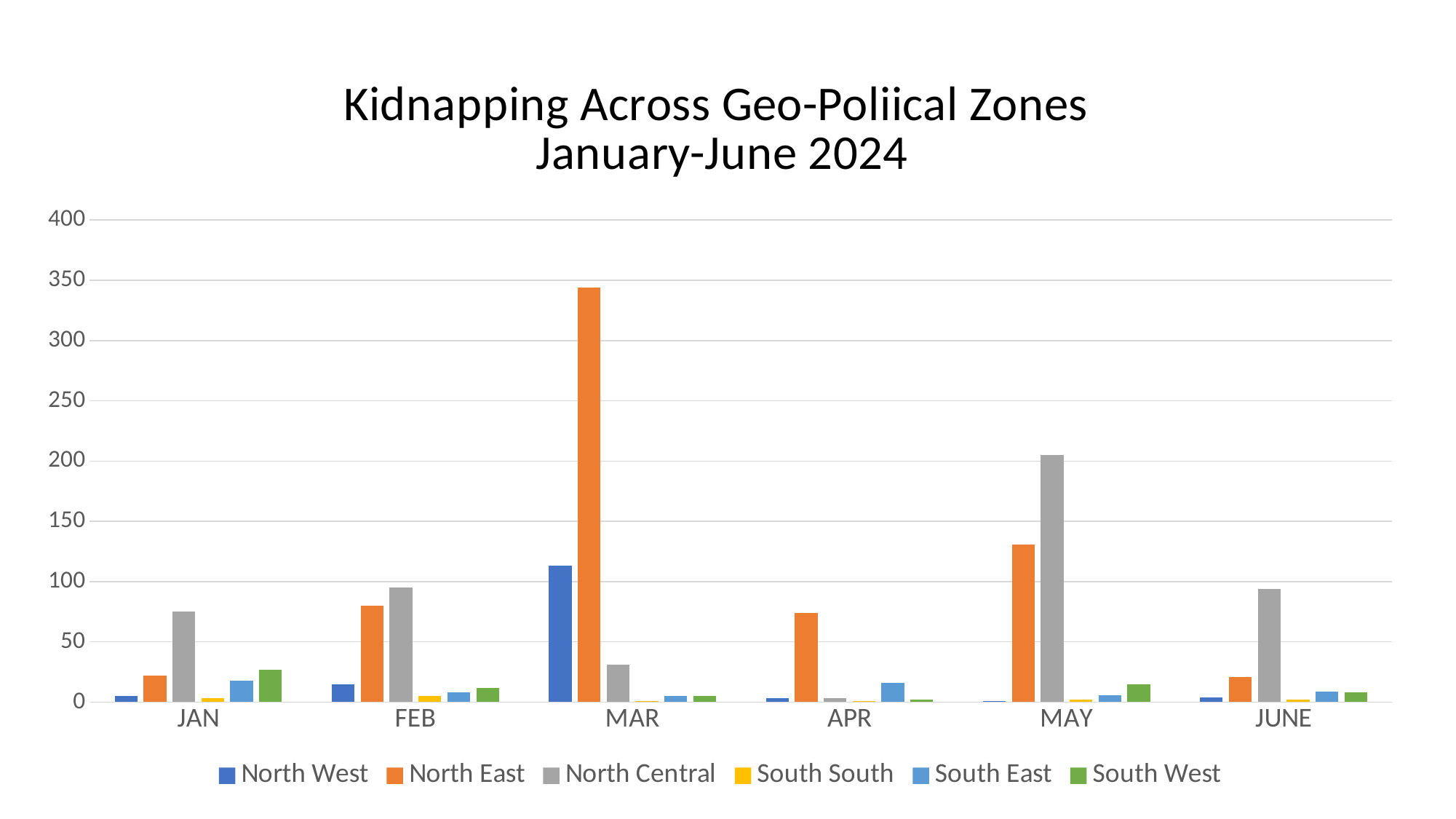
Is the value for North East in APR greater or less than 50? greater Which zone has the highest bar in JAN? North Central How many months are shown along the x axis? 6 In MAY, which is larger: North East or North Central? North Central What is the title of the chart? Kidnapping Across Geo-Poliical Zones January-June 2024 Is the value for North Central in MAY greater or less than 150? greater In which month is the North East bar the tallest? MAR Is the value for North West in MAR greater or less than 100? greater How many series does the legend list? 6 What kind of chart is shown on the slide? bar chart In FEB, which is larger: North East or North Central? North Central